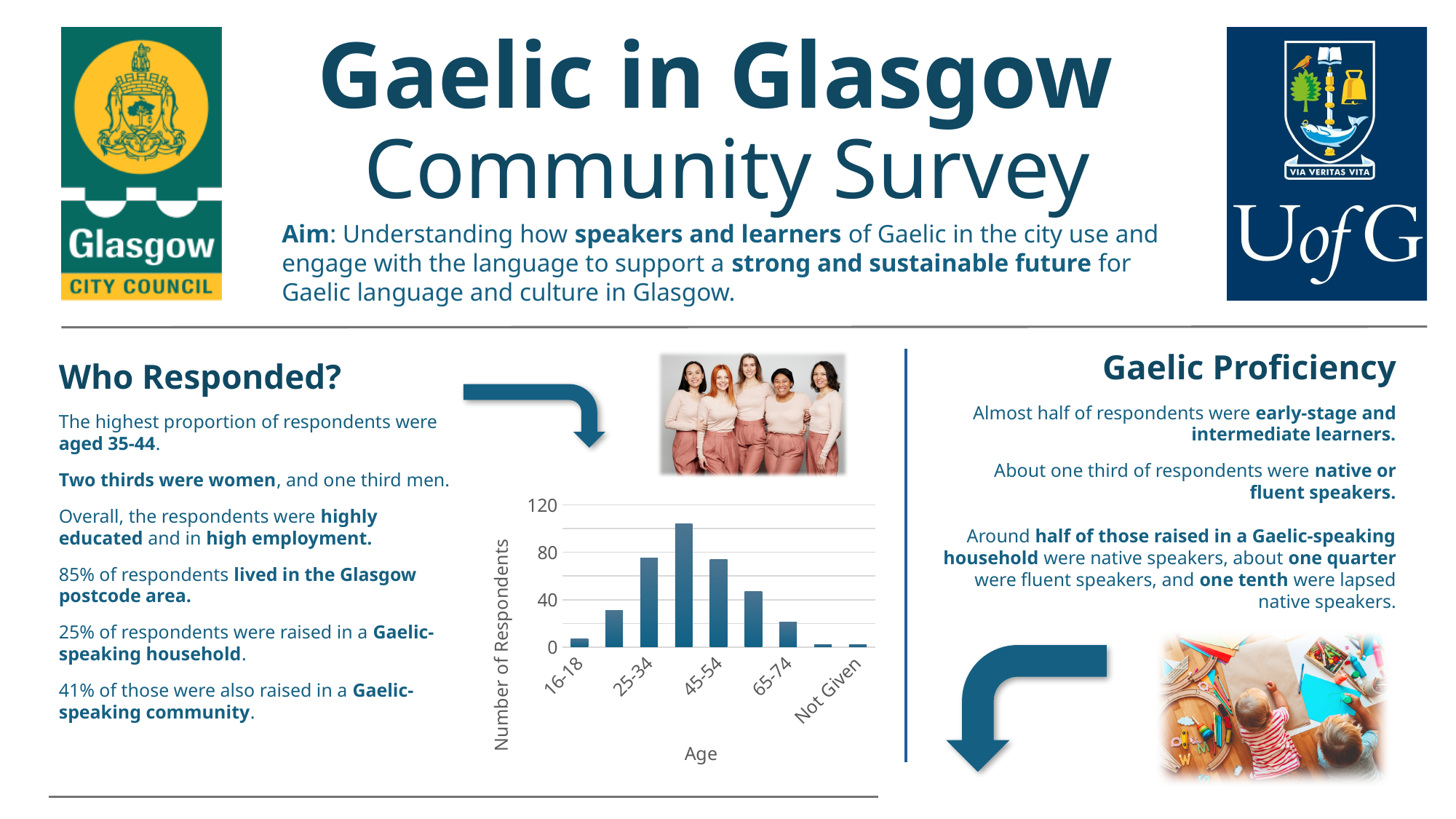
Which has more respondents, the 25-34 age group or the 65-74 age group? 25-34 Which age group had the highest number of respondents? 35-44 Which has more respondents, the 16-18 age group or the 65-74 age group? 65-74 Is the number of respondents aged 45-54 greater or less than 40? greater What kind of chart is shown on the slide? bar chart What is the title of the chart's y axis? Number of Respondents What is the title of the chart's x axis? Age Is the number of respondents aged 25-34 greater or less than 40? greater Is the number of respondents aged 16-18 greater or less than 40? less How many bars does the chart show? 9